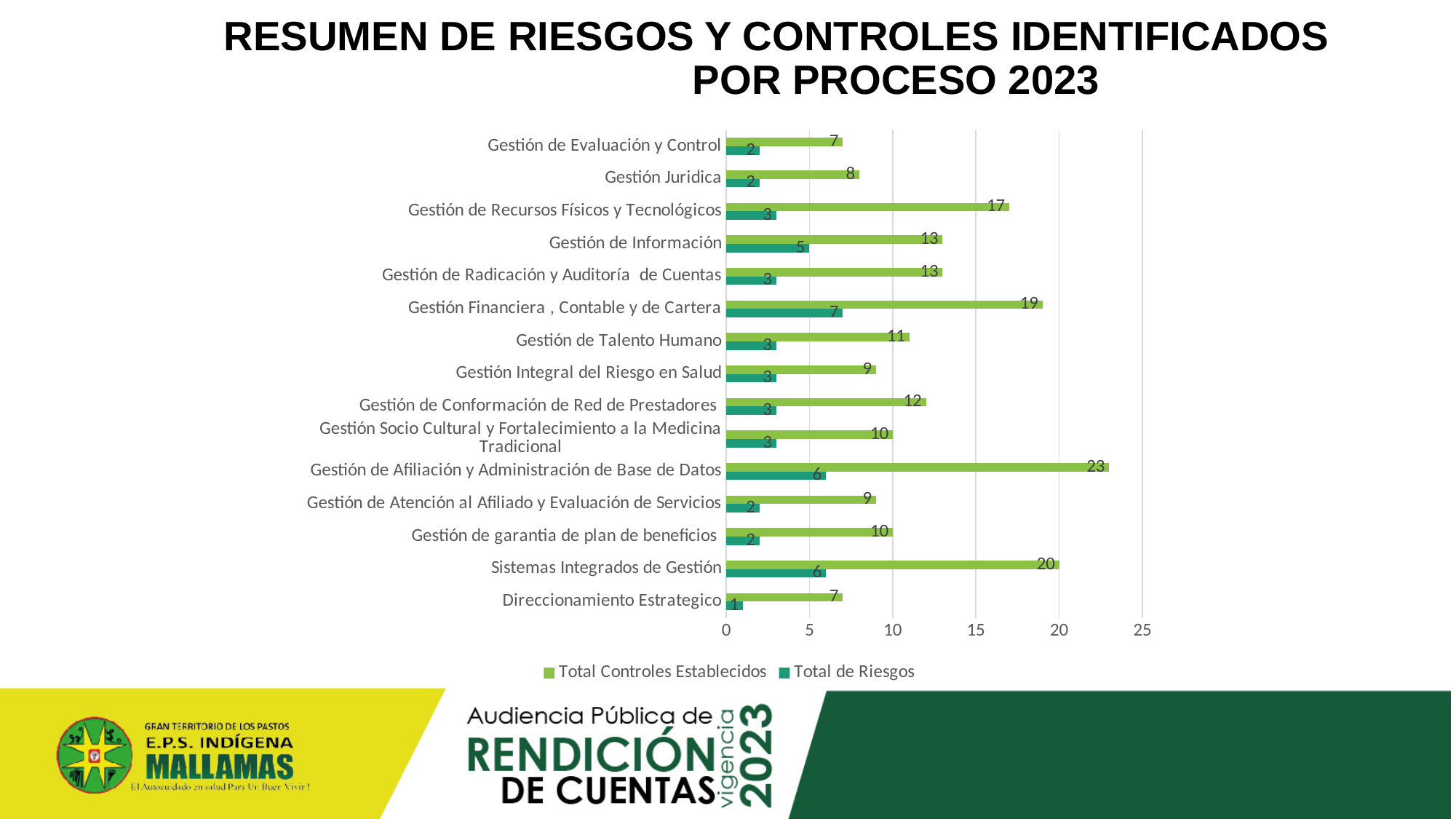
What type of chart is shown on the slide? Bar chart What is the value of Total Controles Establecidos for Gestión de Afiliación y Administración de Base de Datos? 23 Which process has the highest value for Total Controles Establecidos? Gestión de Afiliación y Administración de Base de Datos Which process has the lowest value for Total de Riesgos? Direccionamiento Estrategico Which process has the highest value for Total de Riesgos? Gestión Financiera , Contable y de Cartera Which has more Total Controles Establecidos: Gestión de Recursos Físicos y Tecnológicos or Gestión de Talento Humano? Gestión de Recursos Físicos y Tecnológicos How many series does the legend list? 2 How many processes are shown on the chart? 15 What is the value of Total de Riesgos for Gestión de Información? 5 What is the difference between Total Controles Establecidos and Total de Riesgos for Sistemas Integrados de Gestión? 14 Is the value of Total Controles Establecidos for Gestión Financiera , Contable y de Cartera greater or less than 15? greater What is the value of Total de Riesgos for Gestión Financiera , Contable y de Cartera? 7